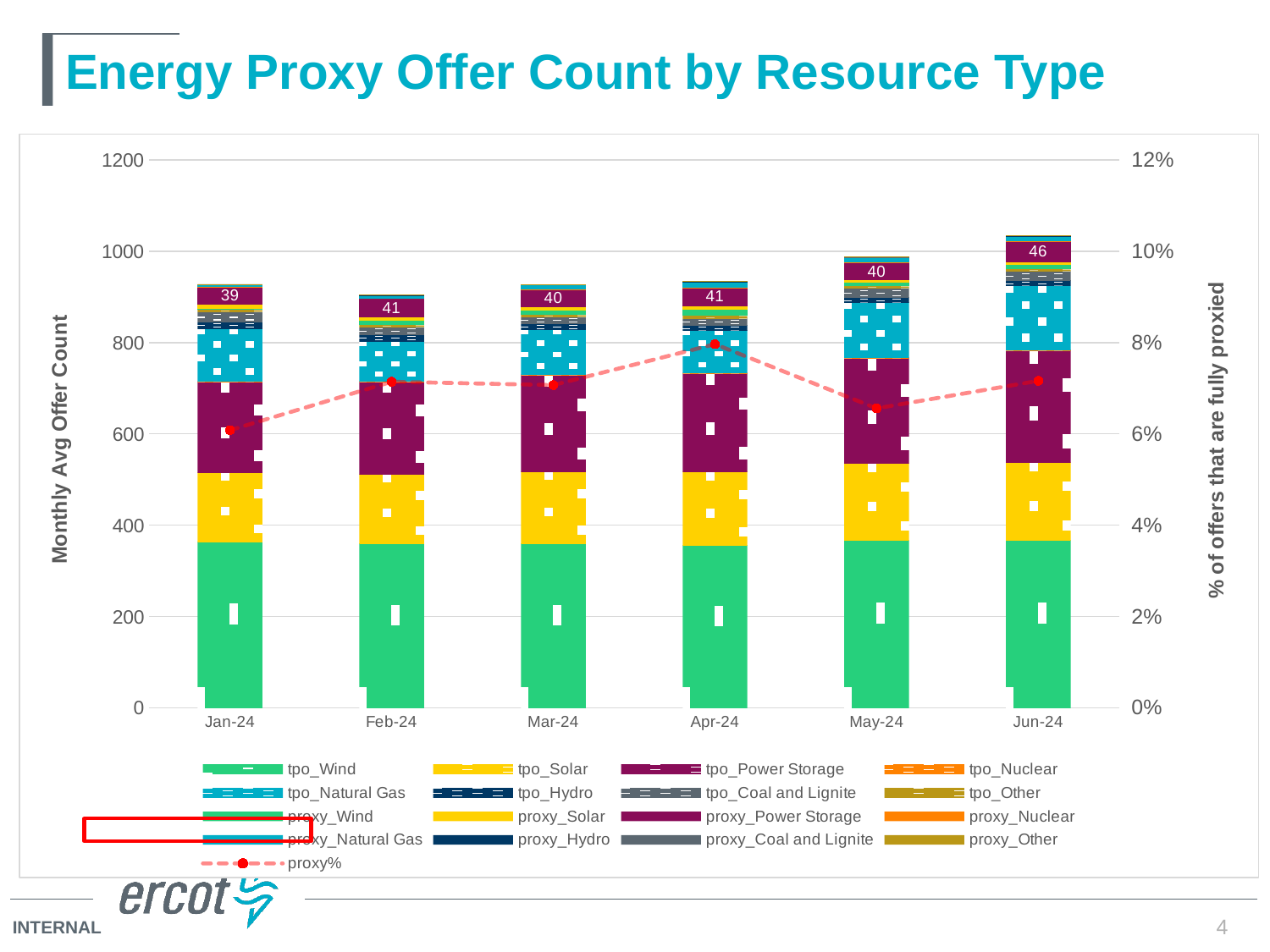
Is the proxy% value for May-24 greater or less than 7%? less Which month has the highest labelled value on its bar? Jun-24 Is the total height of the Jun-24 bar greater or less than 1000? greater How many months are shown on the x axis? 6 What is the data label shown on the Jan-24 bar? 39 Which month has the highest proxy% value on the dashed line? Apr-24 What is the data label shown on the Jun-24 bar? 46 What is the title of the right-hand vertical axis? % of offers that are fully proxied What is the difference between the labelled values on the Jun-24 and Jan-24 bars? 7 Which month has the lowest labelled value on its bar? Jan-24 Which month has the lowest proxy% value on the dashed line? Jan-24 Which month has the tallest stacked bar overall? Jun-24